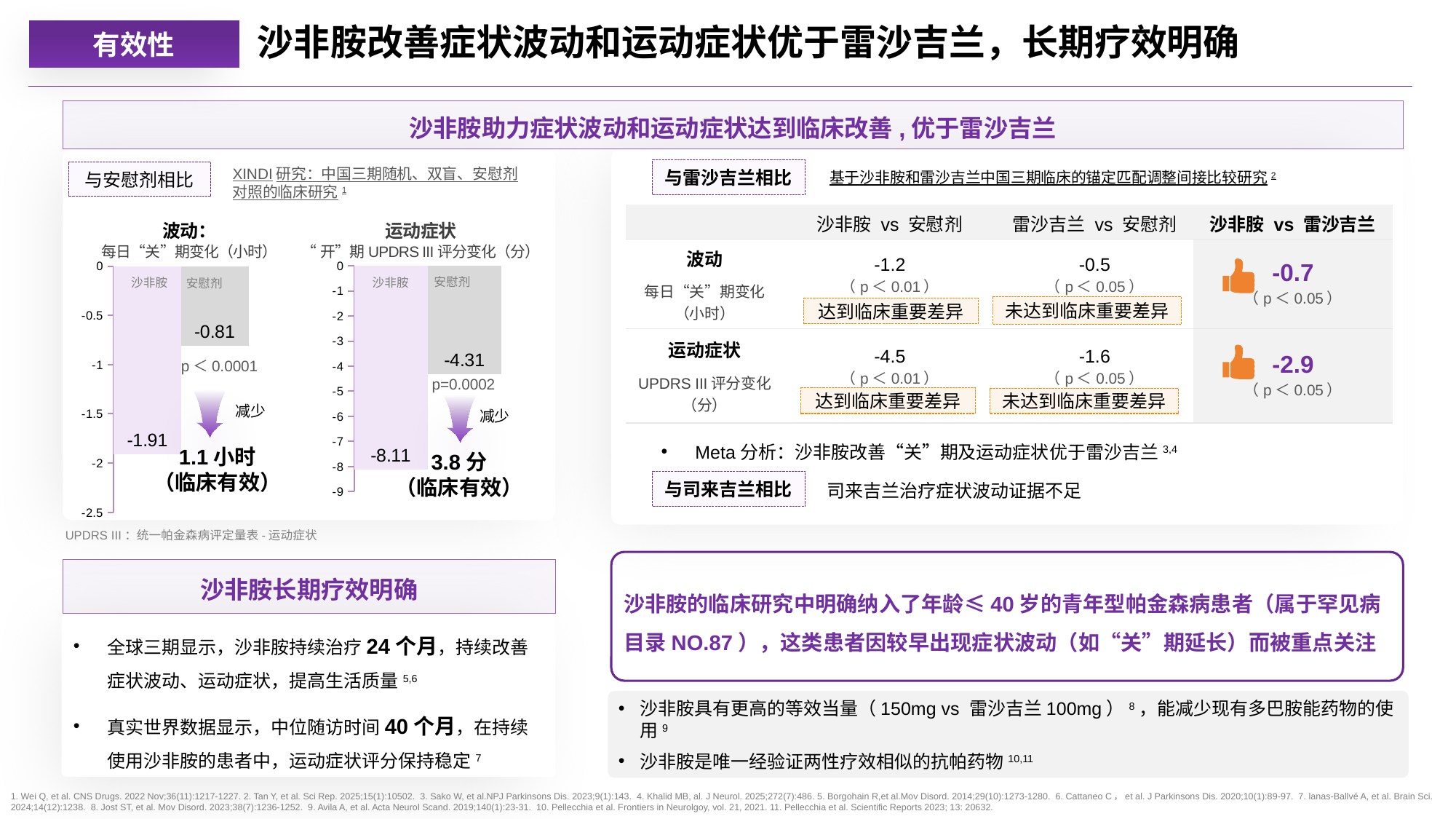
在“运动症状”图表中，沙非胺组“开”期 UPDRS III 评分变化的数值是多少？ -8.11 在“波动”图表中，沙非胺组每日“关”期变化的数值是多少？ -1.91 在“波动”图表中，沙非胺组的数值是大于还是小于 -1.5？ 小于 在“运动症状”图表中，安慰剂组“开”期 UPDRS III 评分变化的数值是多少？ -4.31 在“波动”图表中，沙非胺与安慰剂的每日“关”期变化相差多少？ 1.1 小时 在“波动”图表中，哪一组的每日“关”期减少更多？ 沙非胺 “波动”图表中标注的 p 值是多少？ p＜0.0001 在“运动症状”图表中，哪一组的 UPDRS III 评分下降幅度更大？ 沙非胺 在“波动”图表中，安慰剂组每日“关”期变化的数值是多少？ -0.81 “运动症状”图表中有几个分组（柱子）？ 2 在“运动症状”图表中，沙非胺与安慰剂的 UPDRS III 评分变化相差多少？ 3.8 分 “波动”图表是什么类型的图表？ 柱状图（条形图）